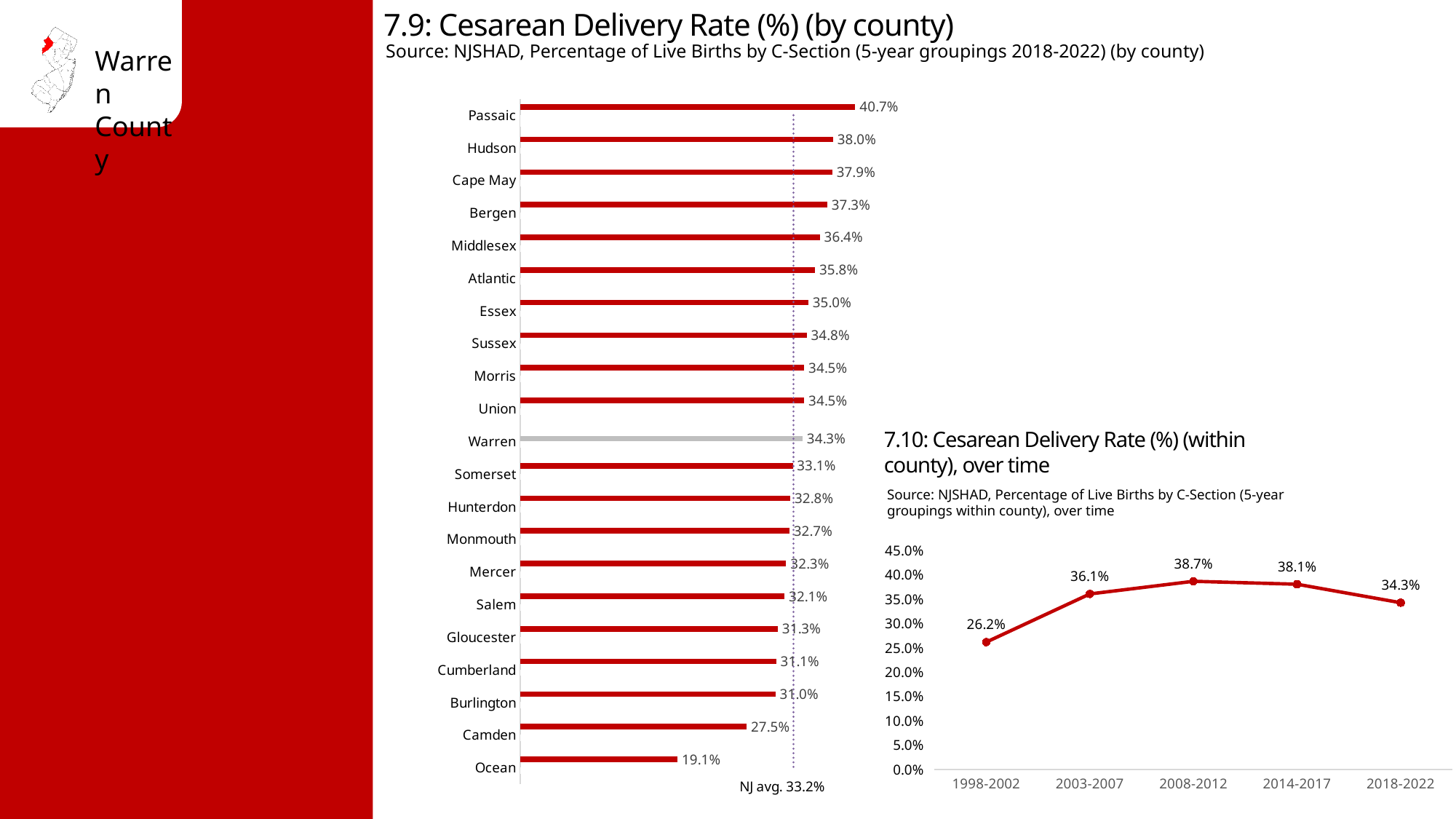
In the 7.9 Cesarean Delivery Rate (by county) chart, what is the value for Warren? 34.3% In the 7.9 Cesarean Delivery Rate (by county) chart, which county has the lowest rate? Ocean What kind of chart is the 7.10 Cesarean Delivery Rate (within county) over time chart? Line chart In the 7.10 Cesarean Delivery Rate (within county) over time chart, what is the value for 2008-2012? 38.7% In the 7.9 Cesarean Delivery Rate (by county) chart, what is the NJ average shown by the dotted line? 33.2% In the 7.10 Cesarean Delivery Rate (within county) over time chart, which period has the lowest rate? 1998-2002 In the 7.9 Cesarean Delivery Rate (by county) chart, which is larger, Hudson or Cape May? Hudson In the 7.9 Cesarean Delivery Rate (by county) chart, what is the difference between Passaic and Ocean? 21.6% What kind of chart is the 7.9 Cesarean Delivery Rate (by county) chart? Bar chart In the 7.10 Cesarean Delivery Rate (within county) over time chart, what is the difference between 2003-2007 and 1998-2002? 9.9% In the 7.9 Cesarean Delivery Rate (by county) chart, how many counties are shown? 21 In the 7.9 Cesarean Delivery Rate (by county) chart, which county has the highest rate? Passaic